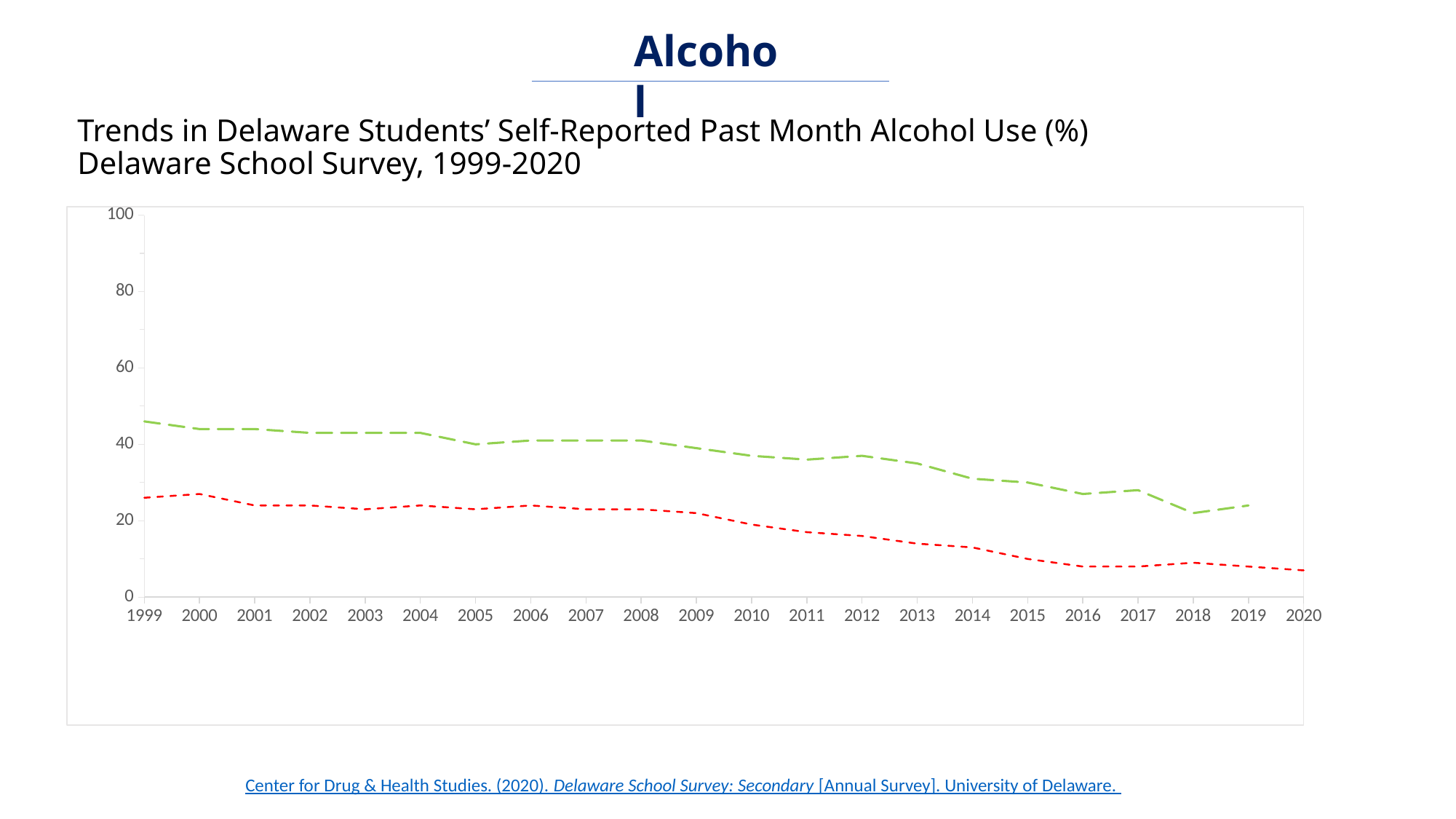
What is the last year shown on the x axis? 2020 Is the value of the red dashed line in 2020 greater or less than 10? less Does the green dashed line rise or fall overall from 1999 to 2019? fall Is the value of the red dashed line in 2012 greater or less than 20? less Is the value of the green dashed line in 2014 greater or less than 40? less Does the red dashed line rise or fall overall from 1999 to 2020? fall What is the first year shown on the x axis? 1999 What kind of chart is shown on the slide? line chart How many years are shown along the x axis of the chart? 22 In 1999, which line has the higher value, the green dashed line or the red dashed line? green dashed line